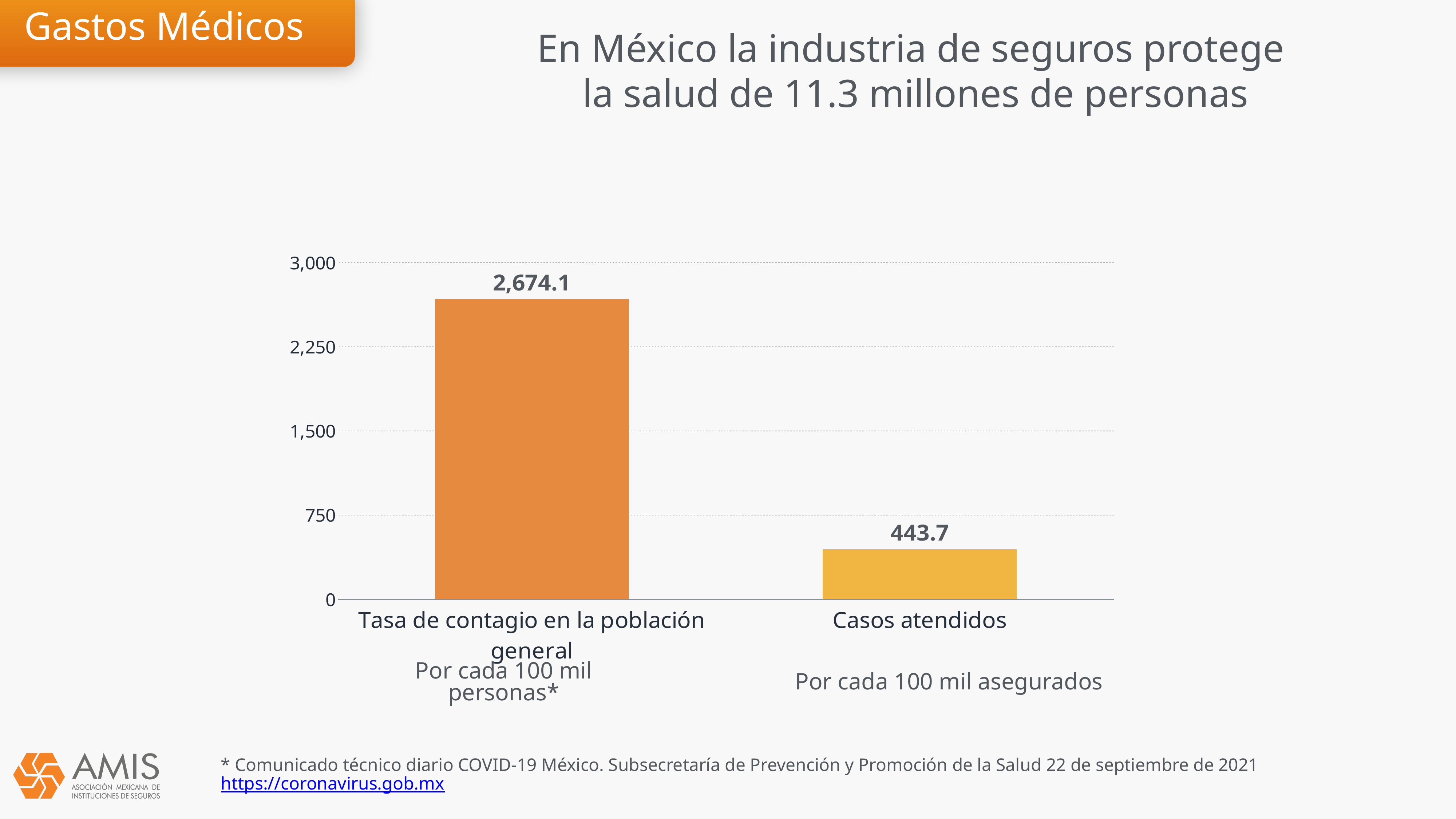
What kind of chart is shown on the slide? bar chart What is the value for "Casos atendidos"? 443.7 Which is larger: the value for "Tasa de contagio en la población general" or the value for "Casos atendidos"? Tasa de contagio en la población general Is the value for "Casos atendidos" greater or less than 750? less What colour is the bar for "Casos atendidos"? yellow Which category has the highest value? Tasa de contagio en la población general Is the value for "Tasa de contagio en la población general" greater or less than 2,250? greater What is the difference between the value for "Tasa de contagio en la población general" and the value for "Casos atendidos"? 2,230.4 How many categories are shown in the chart? 2 What is the highest value shown on the vertical axis? 3,000 Which category has the lowest value? Casos atendidos What is the value for "Tasa de contagio en la población general"? 2,674.1